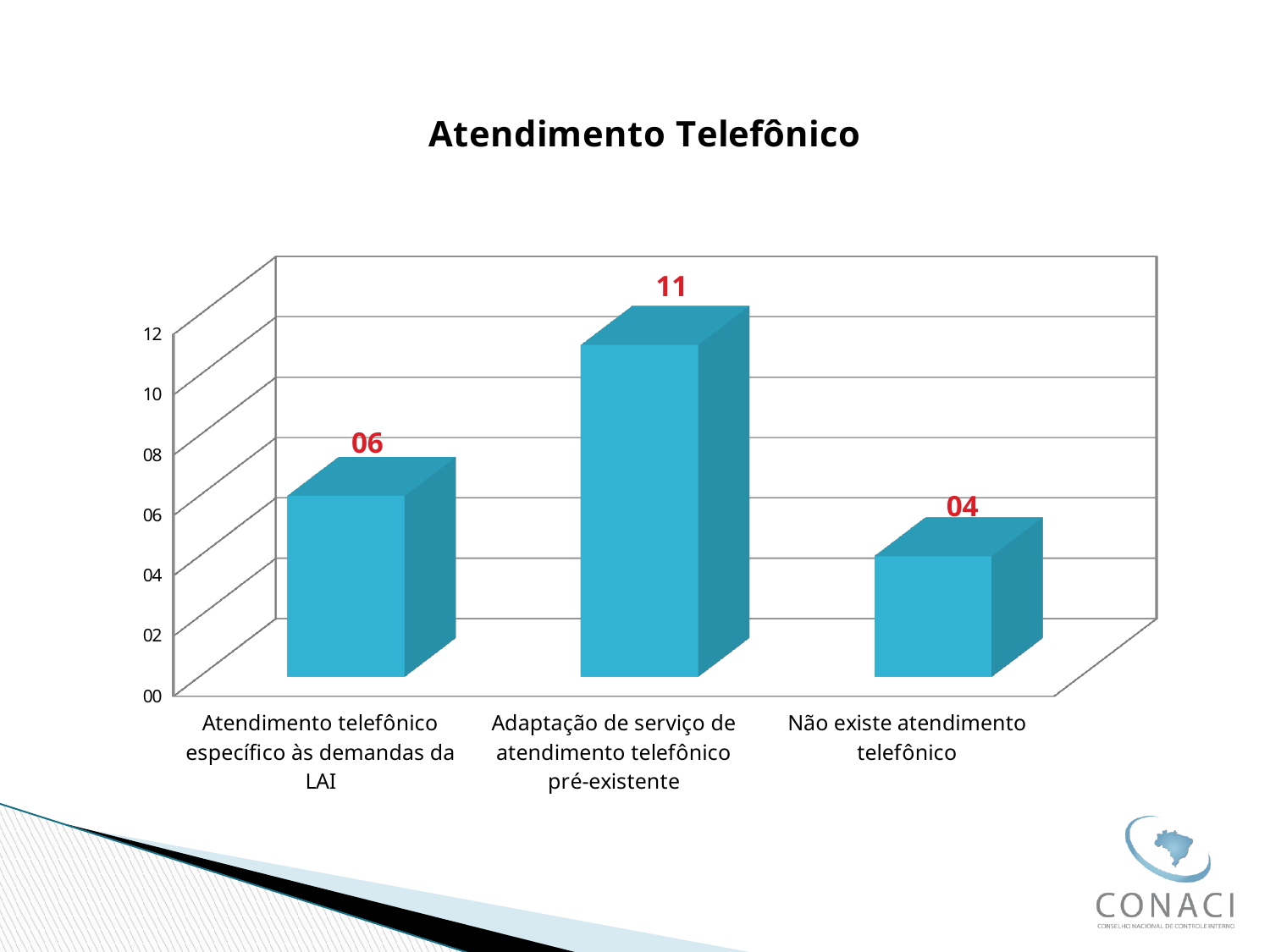
Which is larger: the value for "Atendimento telefônico específico às demandas da LAI" or for "Não existe atendimento telefônico"? Atendimento telefônico específico às demandas da LAI Is the value for "Adaptação de serviço de atendimento telefônico pré-existente" greater or less than 10? greater What is the value for "Adaptação de serviço de atendimento telefônico pré-existente"? 11 Which category has the lowest value? Não existe atendimento telefônico What is the difference between the values for "Atendimento telefônico específico às demandas da LAI" and "Não existe atendimento telefônico"? 2 What is the difference between the values for "Adaptação de serviço de atendimento telefônico pré-existente" and "Atendimento telefônico específico às demandas da LAI"? 5 What is the title of the chart? Atendimento Telefônico What is the value for "Não existe atendimento telefônico"? 04 How many categories are shown in the chart? 3 What is the value for "Atendimento telefônico específico às demandas da LAI"? 06 What kind of chart is shown on the slide? bar chart Which category has the highest value? Adaptação de serviço de atendimento telefônico pré-existente